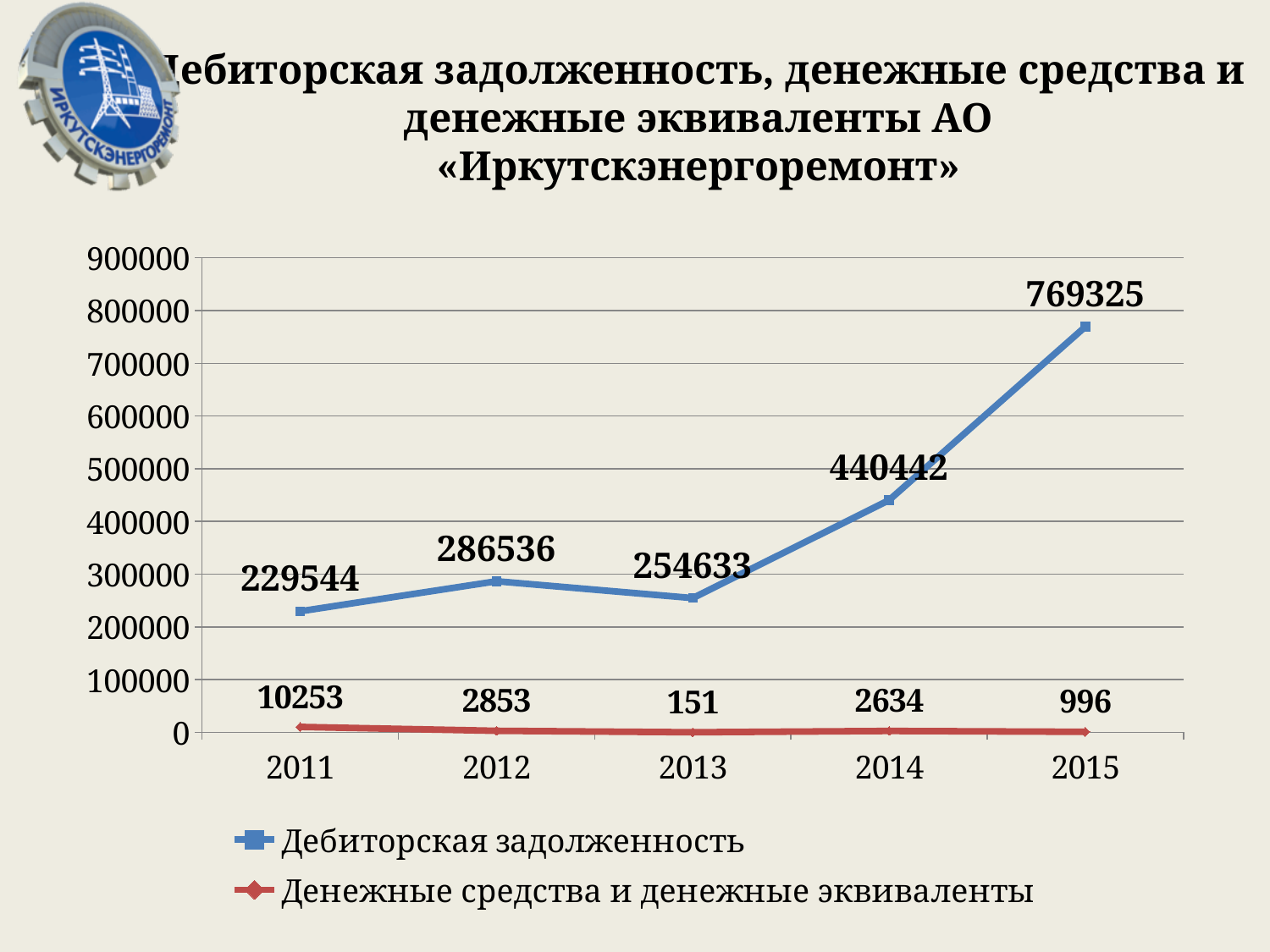
In which year is Дебиторская задолженность highest? 2015 How many series does the legend list? 2 How many years are shown on the x axis? 5 What kind of chart is shown on the slide? line chart What is the value of Денежные средства и денежные эквиваленты in 2013? 151 Is the value of Дебиторская задолженность in 2014 greater or less than 400000? greater What is the value of Дебиторская задолженность in 2015? 769325 Does Дебиторская задолженность rise or fall from 2013 to 2015? rise Which is larger: Дебиторская задолженность in 2012 or in 2013? 2012 What is the difference between Дебиторская задолженность in 2015 and in 2014? 328883 What is the value of Дебиторская задолженность in 2011? 229544 In which year is Денежные средства и денежные эквиваленты lowest? 2013